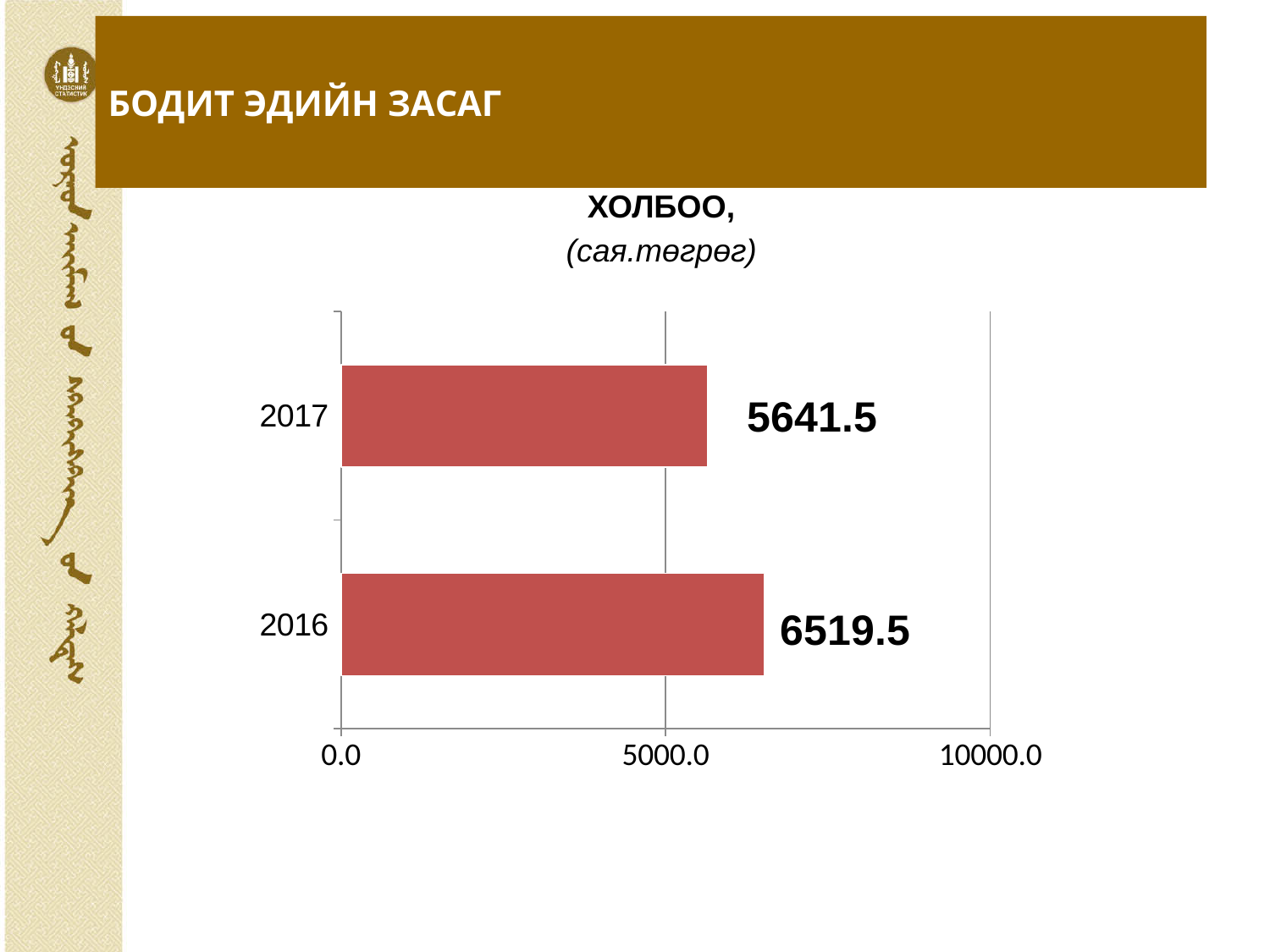
Is the value for 2017 greater or less than 5000.0? greater What kind of chart is shown on the slide? Bar chart What is the highest value shown on the horizontal axis? 10000.0 Which year has the higher value? 2016 What is the value for 2016? 6519.5 How many years are shown in the chart? 2 What is the difference between the 2016 and 2017 values? 878.0 What is the title of the chart? ХОЛБОО, (сая.төгрөг) Which year has the lower value? 2017 What is the value for 2017? 5641.5 Is the value for 2016 larger than the value for 2017? Yes Is the value for 2016 greater or less than 10000.0? less